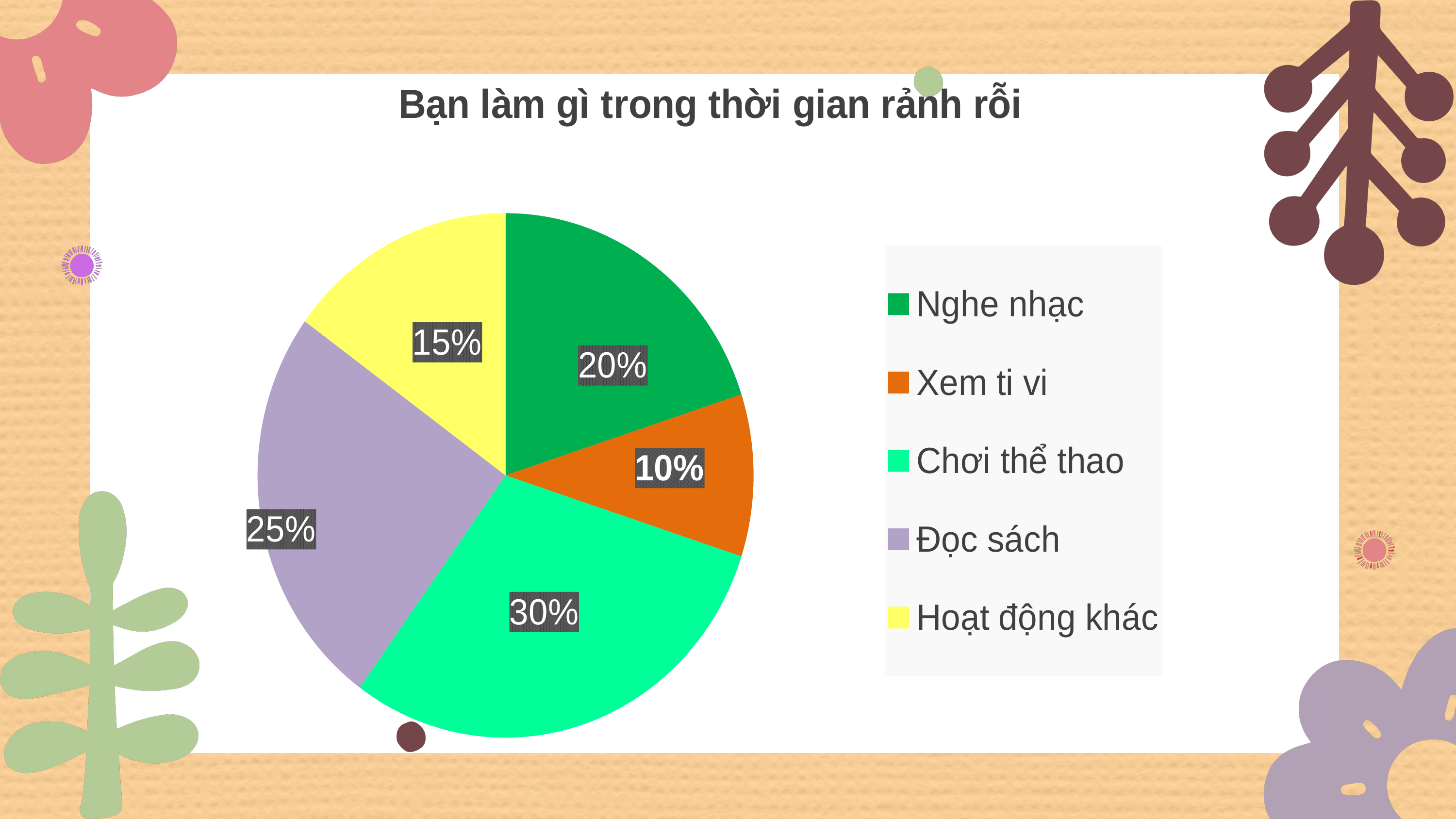
What share of the pie does Nghe nhạc have? 20% What share of the pie does Chơi thể thao have? 30% What share of the pie does Đọc sách have? 25% What share of the pie does Hoạt động khác have? 15% Which is larger, the share for Nghe nhạc or the share for Hoạt động khác? Nghe nhạc What kind of chart is shown on the slide? Pie chart How many categories are shown in the pie chart? 5 Which category has the largest slice of the pie? Chơi thể thao What is the title of the chart? Bạn làm gì trong thời gian rảnh rỗi What share of the pie does Xem ti vi have? 10% What is the difference between the shares for Chơi thể thao and Đọc sách? 5% Which category has the smallest slice of the pie? Xem ti vi